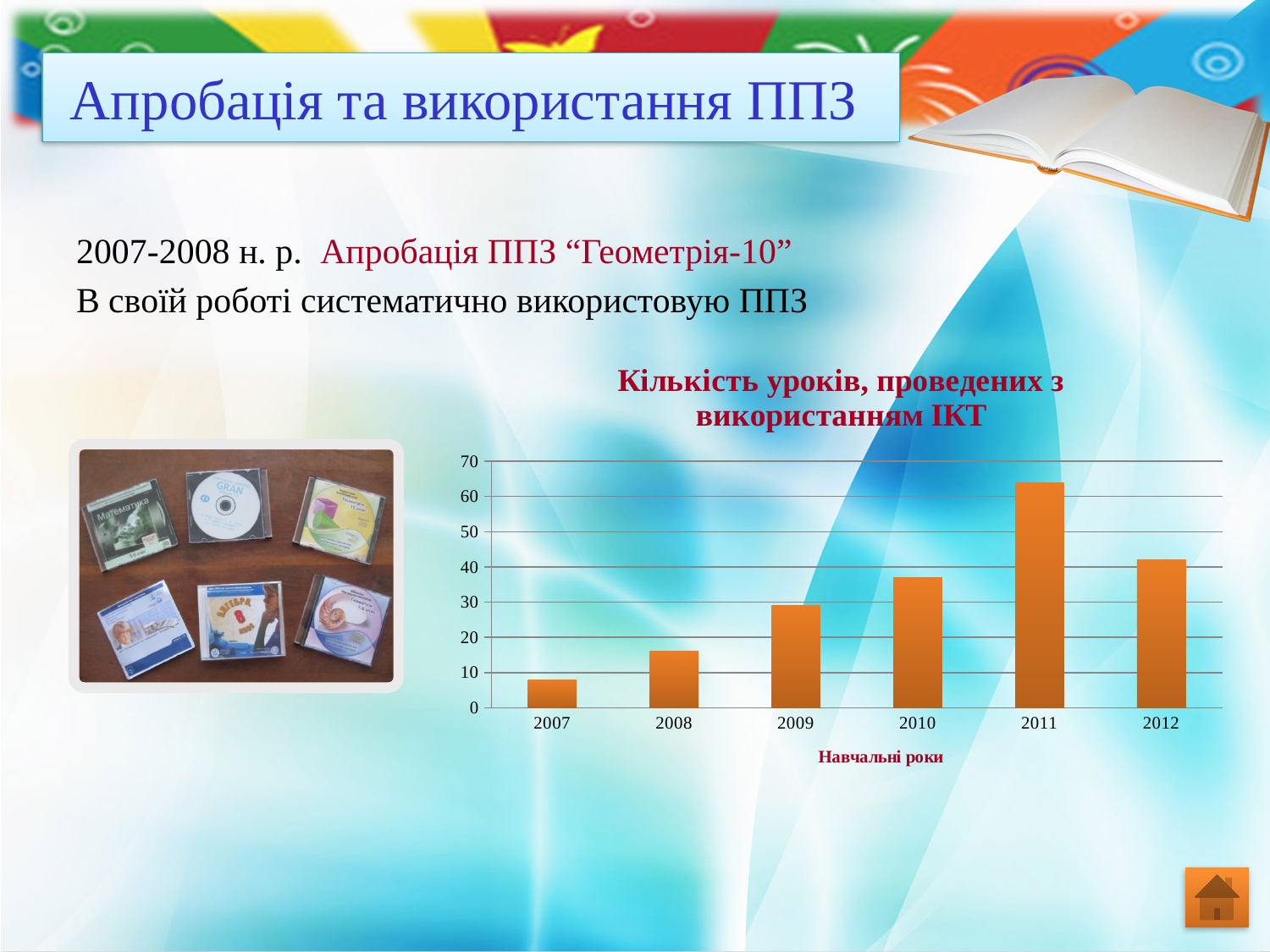
Which year has the lowest number of lessons in the chart? 2007 What is the label of the x axis of the chart? Навчальні роки Which year has the highest number of lessons in the chart? 2011 What kind of chart is shown on the slide? bar chart Is the value for 2008 greater or less than 10? greater How many years are shown on the x axis of the chart? 6 Is the value for 2011 greater or less than 60? greater Is the value for 2007 greater or less than 10? less From 2007 to 2011, do the values rise or fall? rise Which year has the larger value, 2010 or 2012? 2012 What is the title of the chart? Кількість уроків, проведених з використанням ІКТ